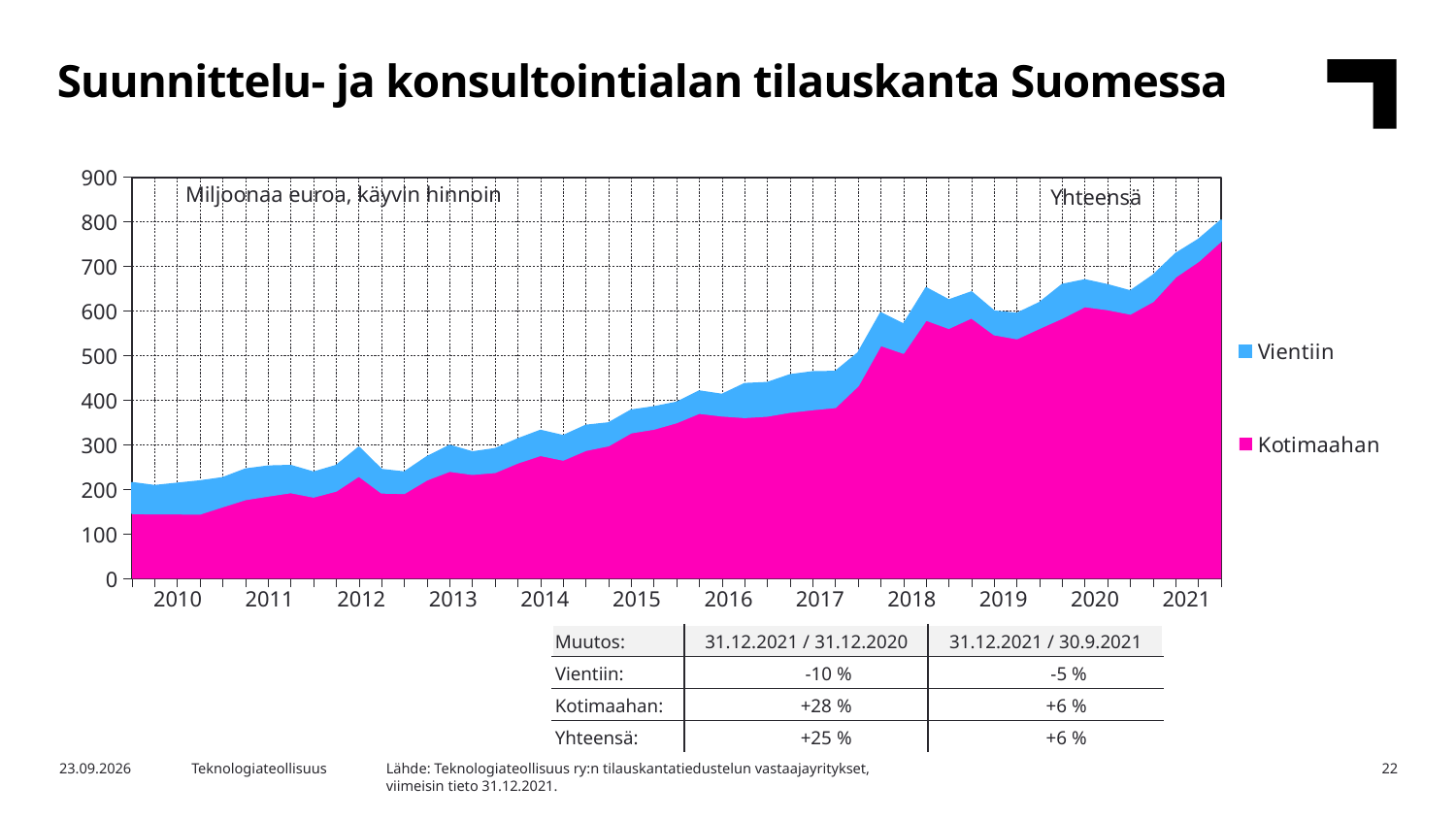
What kind of chart is shown on the slide? Stacked area chart How many series does the chart's legend list? 2 In which year does the total (Yhteensä) reach its highest point on the chart? 2021 What unit is stated in the text box at the top left of the chart? Miljoonaa euroa, käyvin hinnoin Which series is larger at the end of 2021, Vientiin or Kotimaahan? Kotimaahan What are the two series named in the chart's legend? Vientiin and Kotimaahan Is the Kotimaahan value at the start of 2010 greater or less than 200? less Is the Kotimaahan value during 2013 greater or less than 300? less Is the Kotimaahan value at the end of 2021 greater or less than 700? greater How many years are labelled on the x axis of the chart? 12 Does the total order backlog (Yhteensä) generally rise or fall from 2010 to 2021? Rise